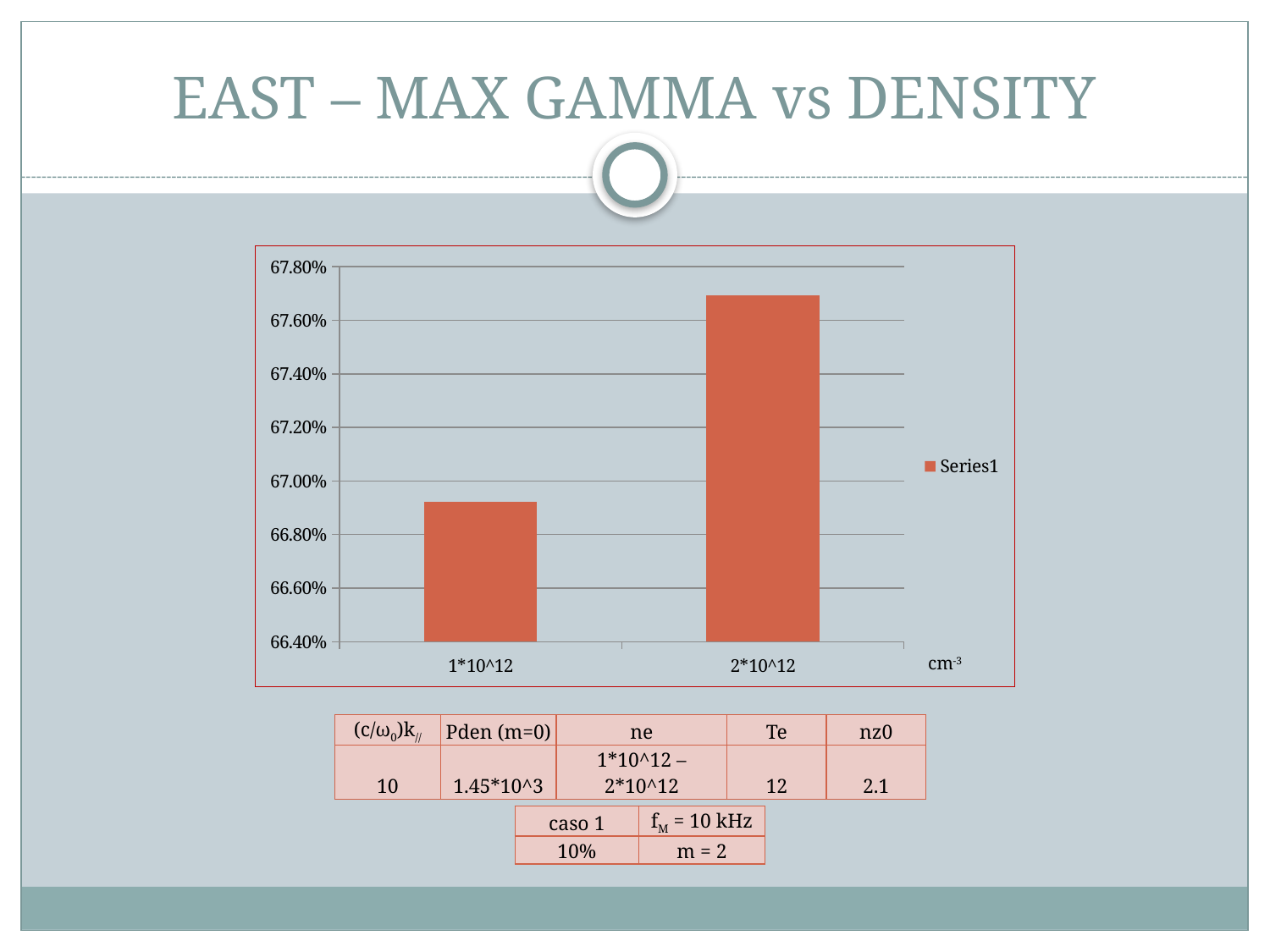
Is the value for 1*10^12 greater or less than 66.80%? greater How many series does the legend list? 1 Is the value for 1*10^12 greater or less than 67.00%? less Do the values rise or fall as density increases along the x axis? rise What is the name of the series shown in the legend? Series1 Which density category has the lowest bar? 1*10^12 Which is larger, the value for 1*10^12 or the value for 2*10^12? 2*10^12 Is the value for 2*10^12 greater or less than 67.60%? greater How many bars (categories) does the chart show? 2 Which density category has the highest bar? 2*10^12 What kind of chart is shown on the slide? bar chart